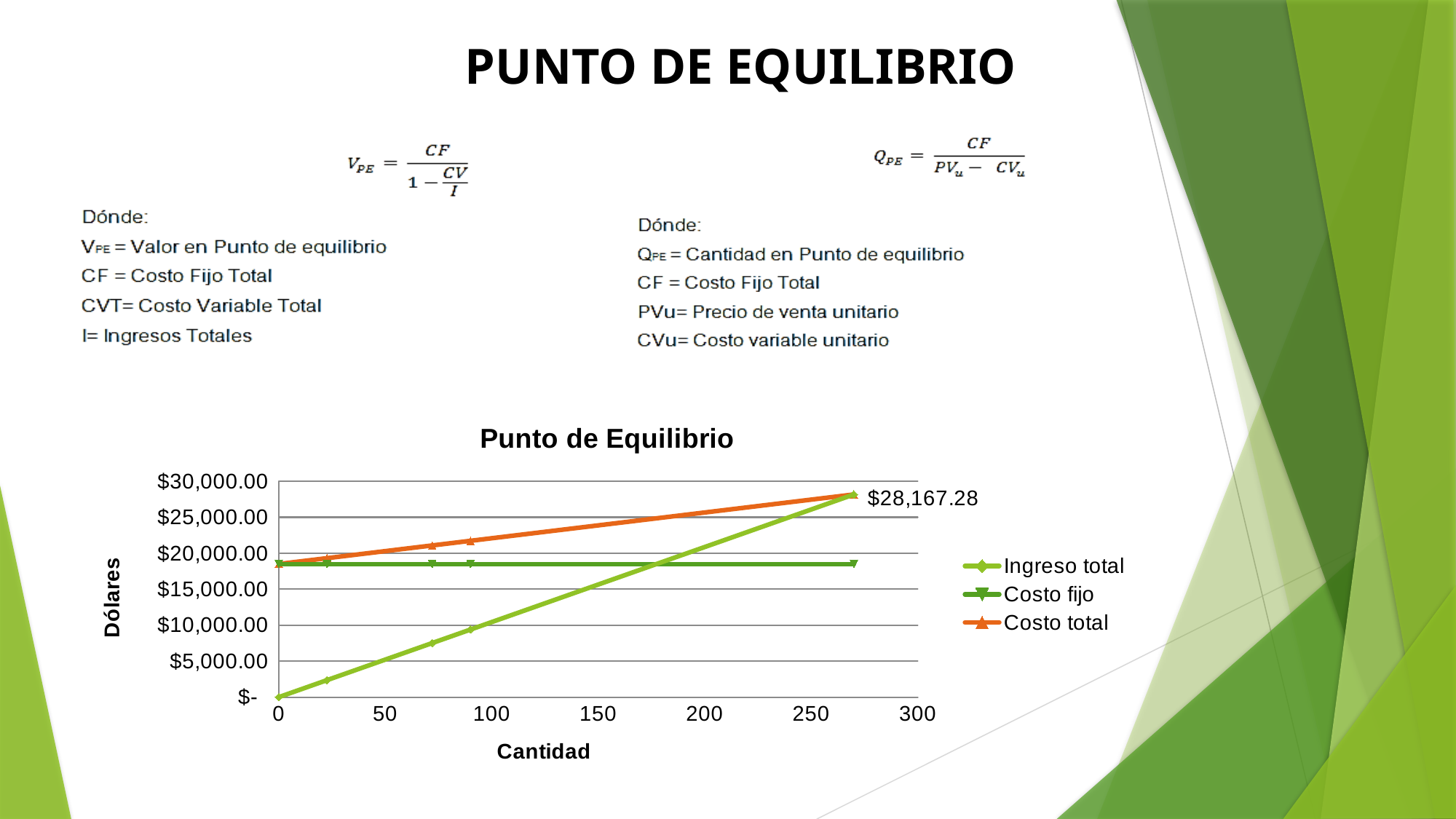
Is the value of 'Ingreso total' at Cantidad 100 greater or less than $15,000.00? less Is the value of 'Costo total' at Cantidad 0 greater or less than $15,000.00? greater What value is printed as a data label at the right end of the lines in the 'Punto de Equilibrio' chart? $28,167.28 What are the three series listed in the legend of the 'Punto de Equilibrio' chart? Ingreso total, Costo fijo, Costo total What kind of chart is shown under the title 'Punto de Equilibrio'? line chart Does the 'Costo fijo' line rise, fall or stay flat as Cantidad increases? stay flat Is the value of 'Costo fijo' greater or less than $20,000.00? less Does the 'Ingreso total' line rise or fall as Cantidad increases? rise How many series does the legend of the 'Punto de Equilibrio' chart list? 3 At Cantidad 250, which is larger: 'Ingreso total' or 'Costo fijo'? Ingreso total What is the x-axis title of the 'Punto de Equilibrio' chart? Cantidad At Cantidad 50, which is larger: 'Costo total' or 'Ingreso total'? Costo total